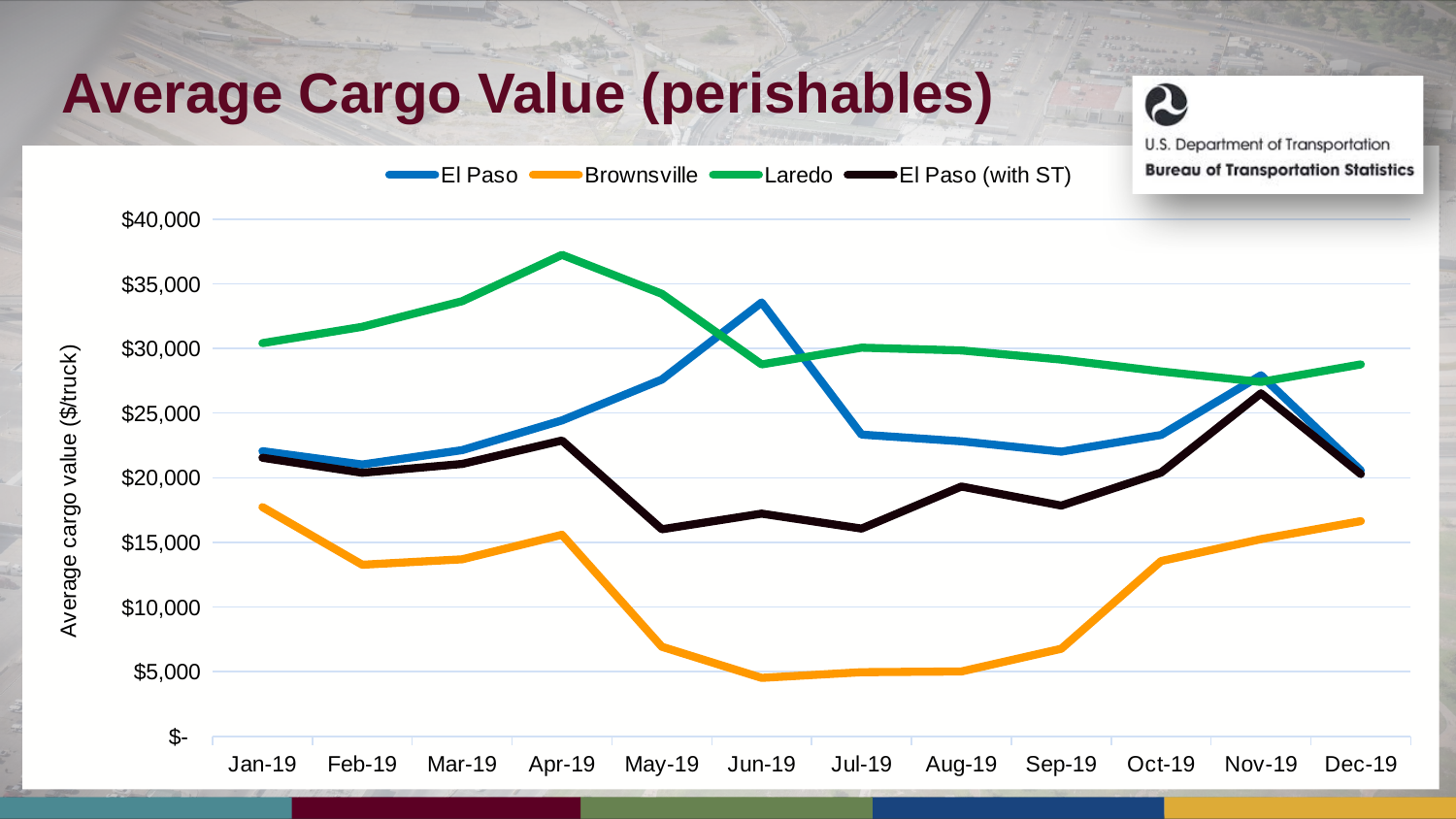
In which month does the El Paso series reach its highest value? Jun-19 Is the value for El Paso (with ST) in Nov-19 greater or less than $25,000? greater Which series has the lowest values throughout the year? Brownsville In Jun-19, which is larger: the El Paso value or the Laredo value? El Paso Does the Brownsville series rise or fall from Jan-19 to Jun-19? Fall In which month does the Laredo series reach its highest value? Apr-19 Is the value for Laredo in Apr-19 greater or less than $35,000? greater What kind of chart is shown on the slide? Line chart How many series does the legend list? 4 What is the label on the y axis? Average cargo value ($/truck) Is the value for Brownsville in Jun-19 greater or less than $5,000? less How many months are plotted along the x axis? 12